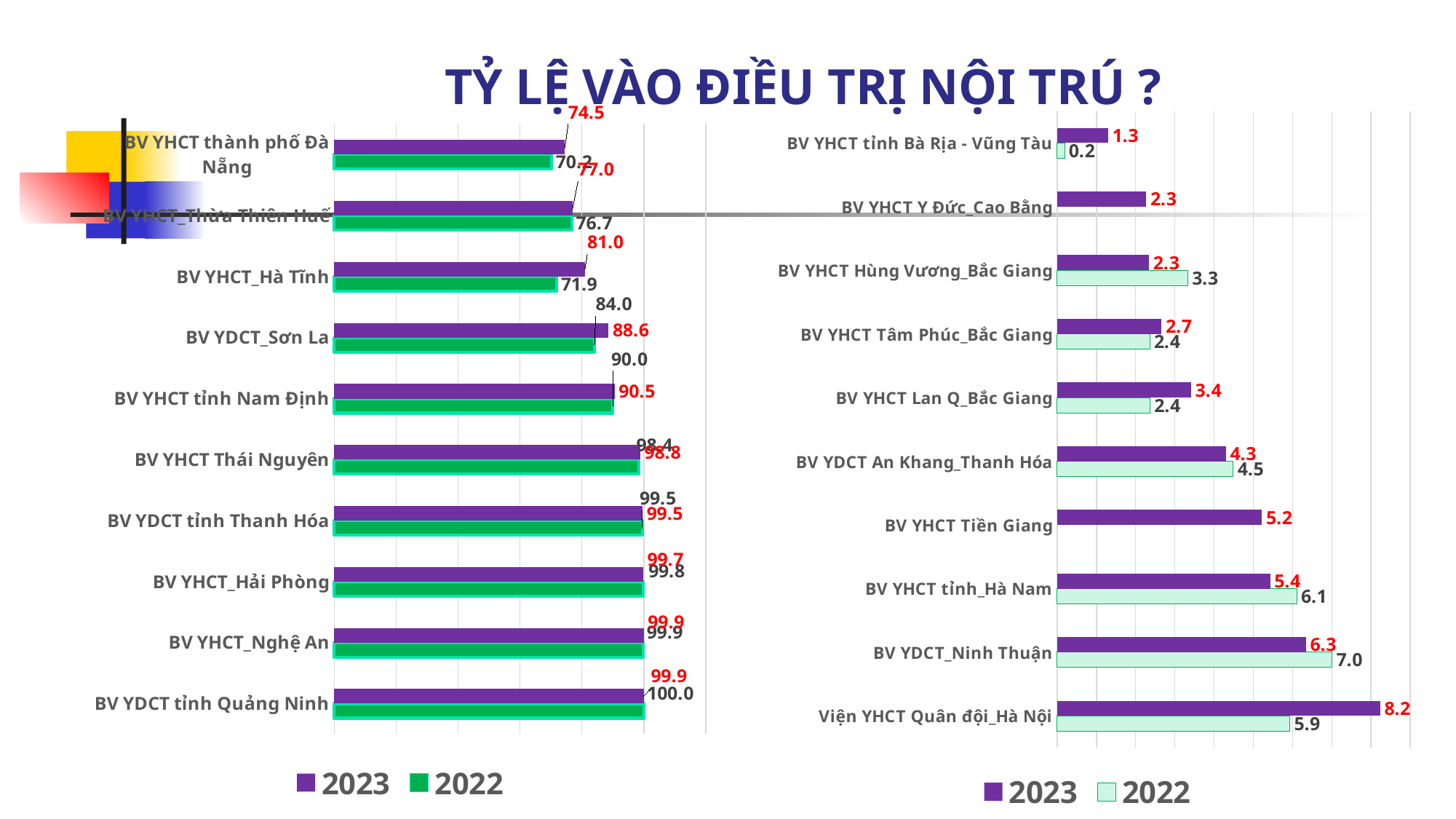
In the left chart, what is the 2022 value for BV YHCT thành phố Đà Nẵng? 70.2 How many series does the legend of the left chart list? 2 In the right chart, what is the difference between the 2022 and 2023 values for BV YHCT tỉnh_Hà Nam? 0.7 In the right chart, is the 2023 value for BV YHCT Lan Q_Bắc Giang larger or smaller than its 2022 value? larger In the right chart, which category has the highest 2023 value? Viện YHCT Quân đội_Hà Nội In the right chart, what is the 2022 value for BV YDCT_Ninh Thuận? 7.0 In the left chart, what is the 2023 value for BV YHCT_Hà Tĩnh? 81.0 In the left chart, which category has the lowest 2023 value? BV YHCT thành phố Đà Nẵng What type of chart is the left chart? bar chart In the left chart, what is the difference between the 2023 and 2022 values for BV YHCT_Hà Tĩnh? 9.1 In the right chart, what is the 2023 value for Viện YHCT Quân đội_Hà Nội? 8.2 How many categories are shown in the right chart? 10